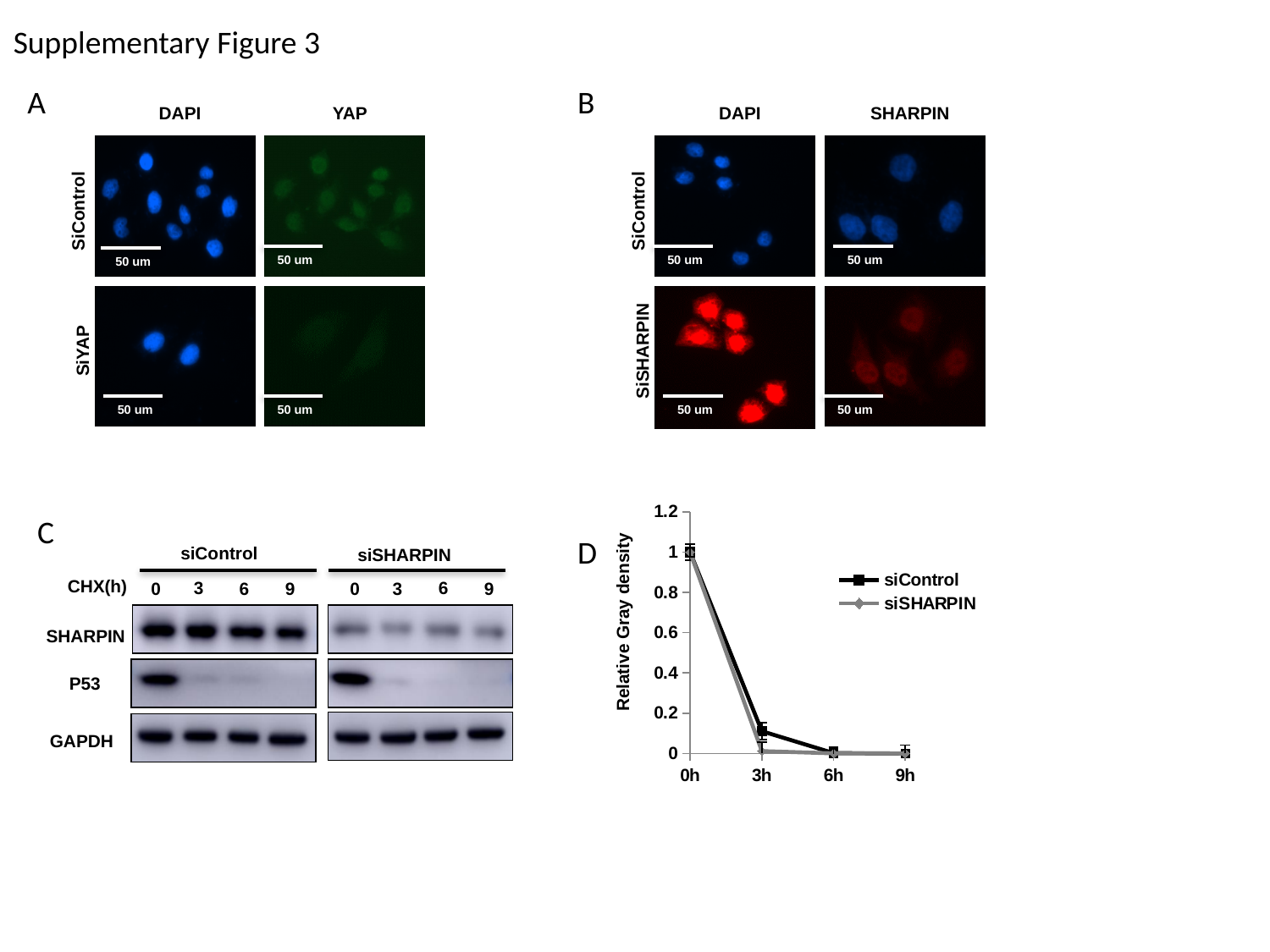
In the chart in panel D, how many time points are shown on the x axis? 4 In the chart in panel D, what is the value for siControl at 0h? 1 What are the two legend entries in the chart in panel D? siControl and siSHARPIN In the chart in panel D, at 3h, which series has the higher value, siControl or siSHARPIN? siControl What is the y-axis label of the chart in panel D? Relative Gray density In the chart in panel D, how many series does the legend list? 2 What kind of chart is panel D? line chart In the chart in panel D, is the value for siSHARPIN at 3h greater or less than 0.2? less In the chart in panel D, at which time point is the siControl value highest? 0h In the chart in panel D, is the value for siControl at 3h greater or less than 0.2? less In the chart in panel D, do the values for siControl rise or fall from 0h to 9h? fall In the chart in panel D, is the value for siControl at 0h greater or less than 0.8? greater